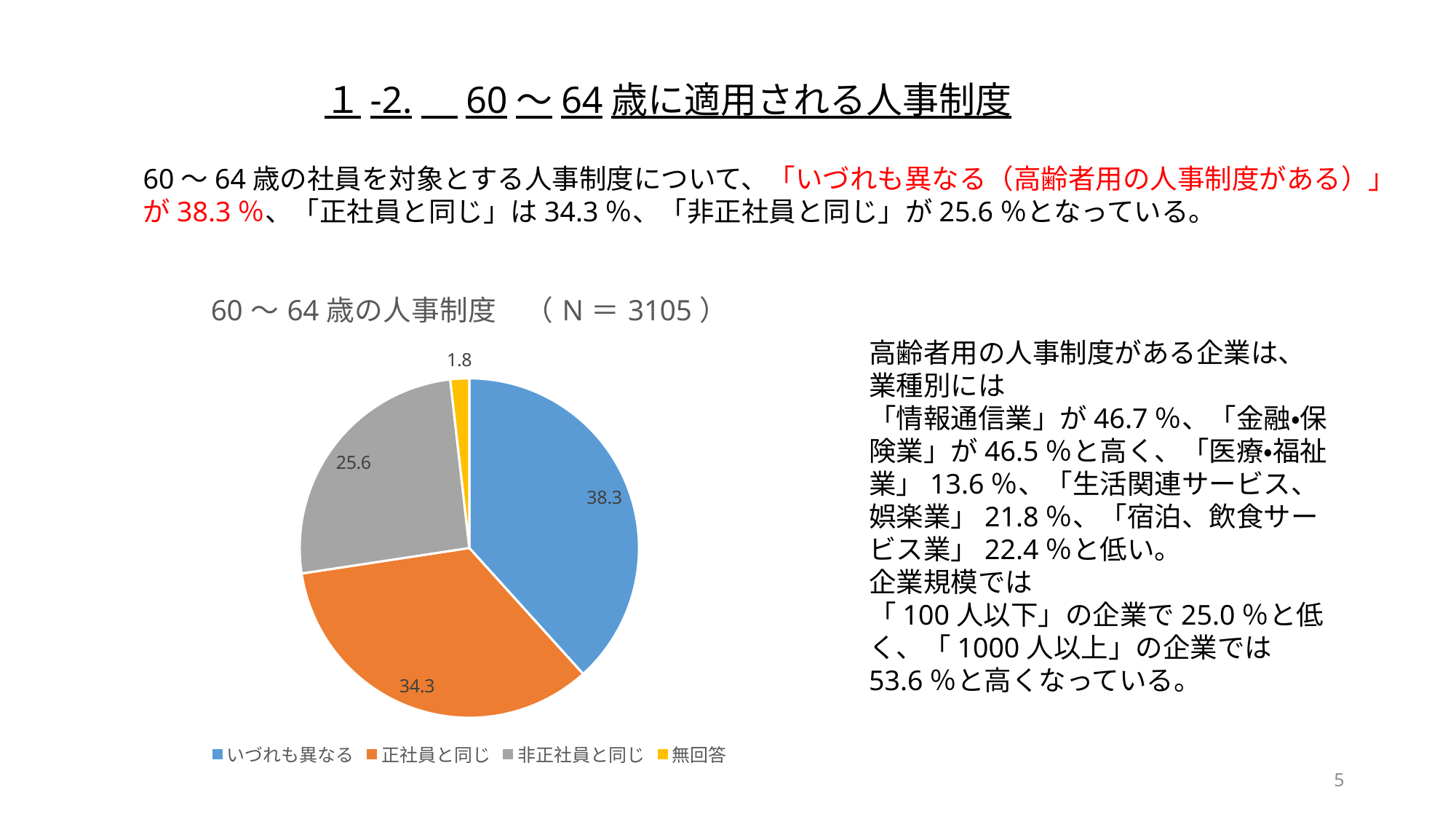
What is the difference between the values for 正社員と同じ and 非正社員と同じ? 8.7 What is the value shown for 正社員と同じ in the pie chart? 34.3 Which category has the smallest slice in the pie chart? 無回答 What is the value shown for いづれも異なる in the pie chart? 38.3 What kind of chart is shown on the slide? pie chart What is the N value shown in the pie chart's title? 3105 How many categories does the legend of the pie chart list? 4 What is the difference between the values for いづれも異なる and 正社員と同じ? 4.0 What is the value shown for 非正社員と同じ in the pie chart? 25.6 Which category has the largest slice in the pie chart? いづれも異なる Which is larger, the value for 非正社員と同じ or the value for 正社員と同じ? 正社員と同じ What is the value shown for 無回答 in the pie chart? 1.8